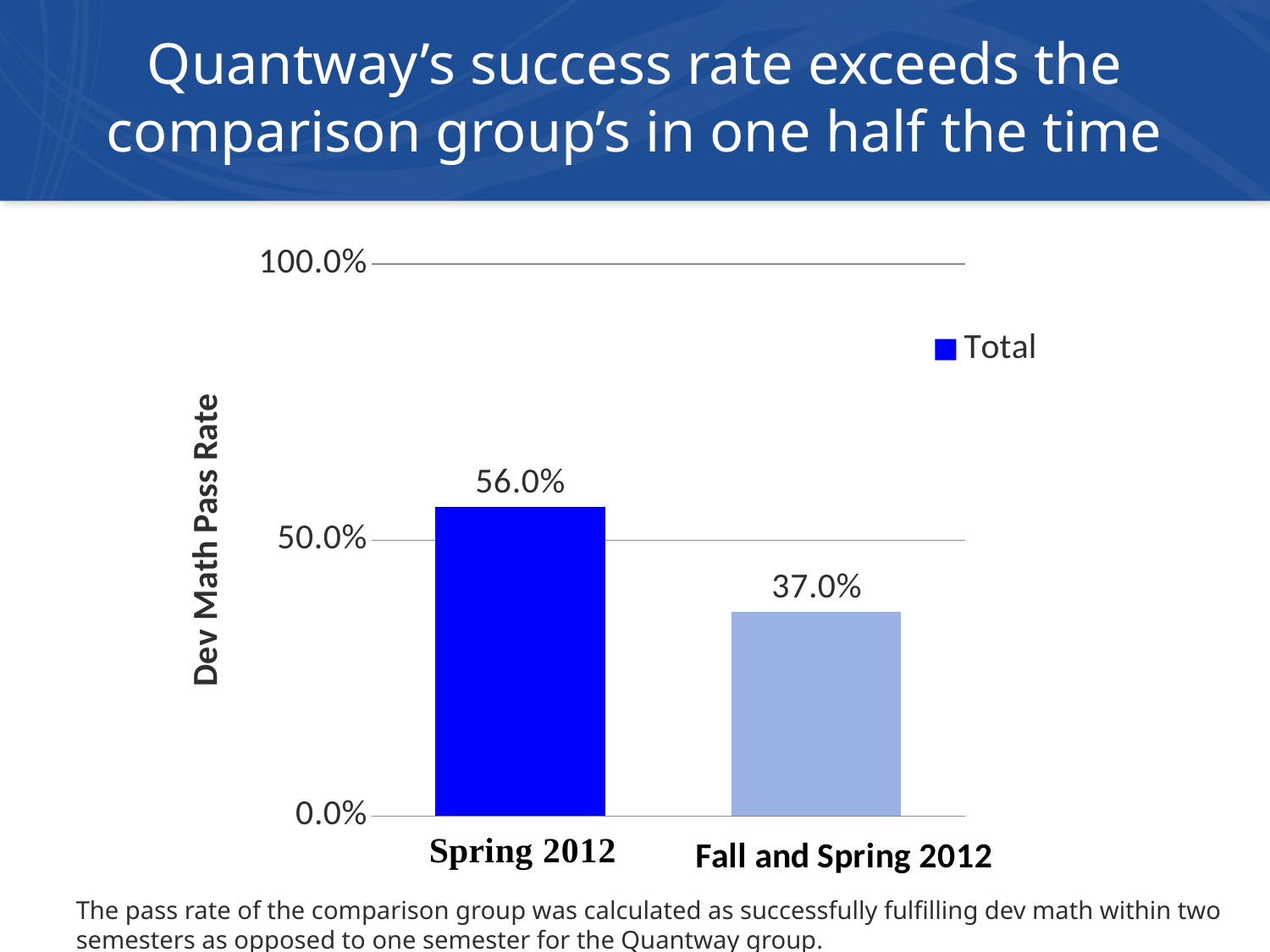
How many series does the legend list? 1 Which is larger, the pass rate for Spring 2012 or for Fall and Spring 2012? Spring 2012 What is the Dev Math Pass Rate for Fall and Spring 2012? 37.0% Is the value for Spring 2012 greater or less than 50.0%? greater What is the difference between the Spring 2012 pass rate and the Fall and Spring 2012 pass rate? 19.0% What is the label on the vertical axis? Dev Math Pass Rate How many categories are shown on the x axis? 2 Which category has the highest pass rate? Spring 2012 Is the value for Fall and Spring 2012 greater or less than 50.0%? less What kind of chart is shown on the slide? bar chart Which category has the lowest pass rate? Fall and Spring 2012 What is the Dev Math Pass Rate for Spring 2012? 56.0%